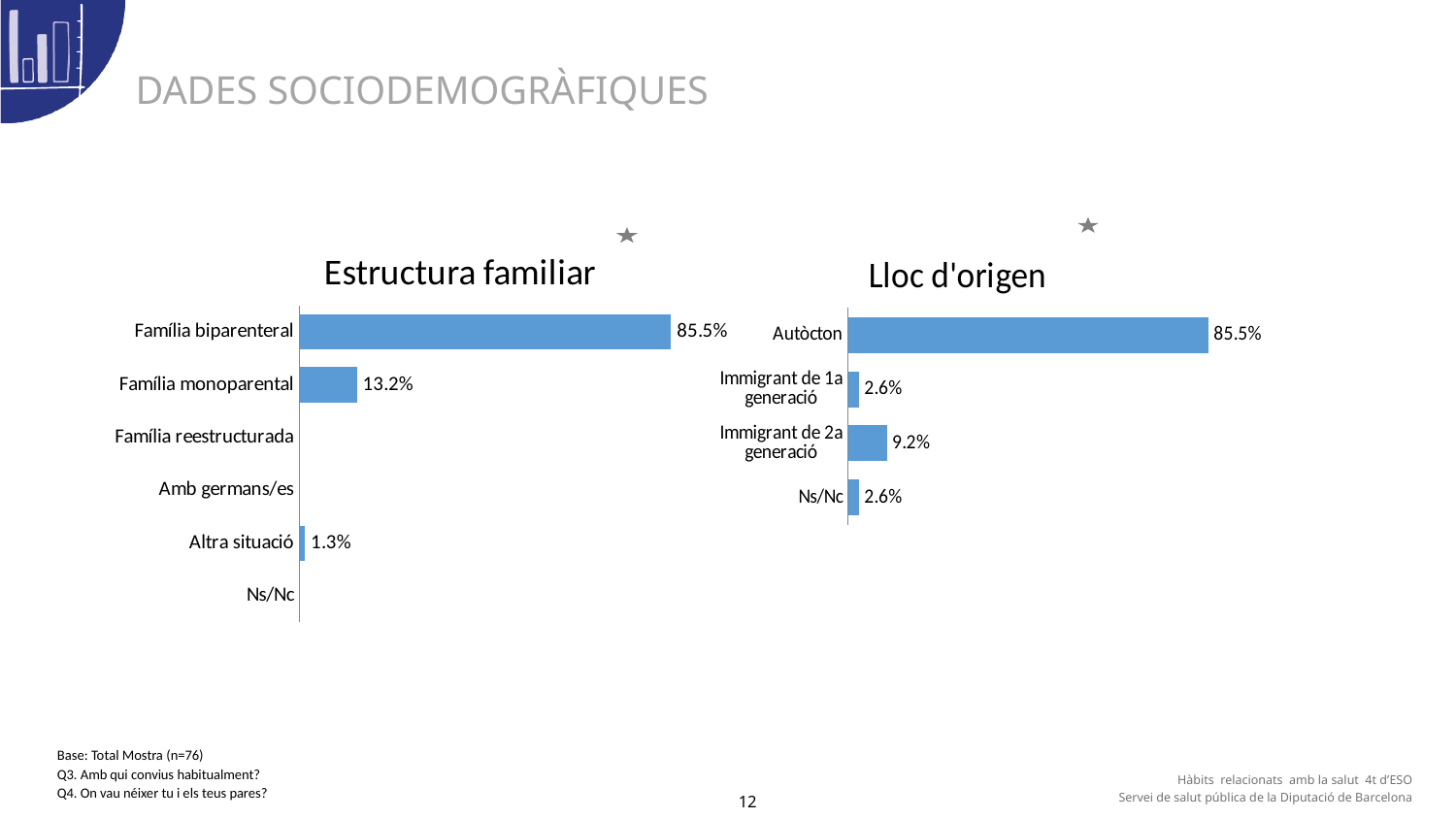
In the 'Estructura familiar' chart, what is the value for Família biparenteral? 85.5% In the 'Estructura familiar' chart, which category has the highest value? Família biparenteral In the 'Lloc d'origen' chart, what is the value for Autòcton? 85.5% In the 'Lloc d'origen' chart, what is the difference between Immigrant de 2a generació and Ns/Nc? 6.6% In the 'Estructura familiar' chart, what is the difference between Família biparenteral and Família monoparental? 72.3% What kind of chart is the 'Lloc d'origen' chart? Bar chart How many categories are shown in the 'Estructura familiar' chart? 6 In the 'Estructura familiar' chart, what is the value for Altra situació? 1.3% In the 'Lloc d'origen' chart, what is the value for Immigrant de 2a generació? 9.2% In the 'Lloc d'origen' chart, which is larger: Immigrant de 1a generació or Immigrant de 2a generació? Immigrant de 2a generació In the 'Lloc d'origen' chart, which category has the highest value? Autòcton In the 'Estructura familiar' chart, what is the value for Família monoparental? 13.2%